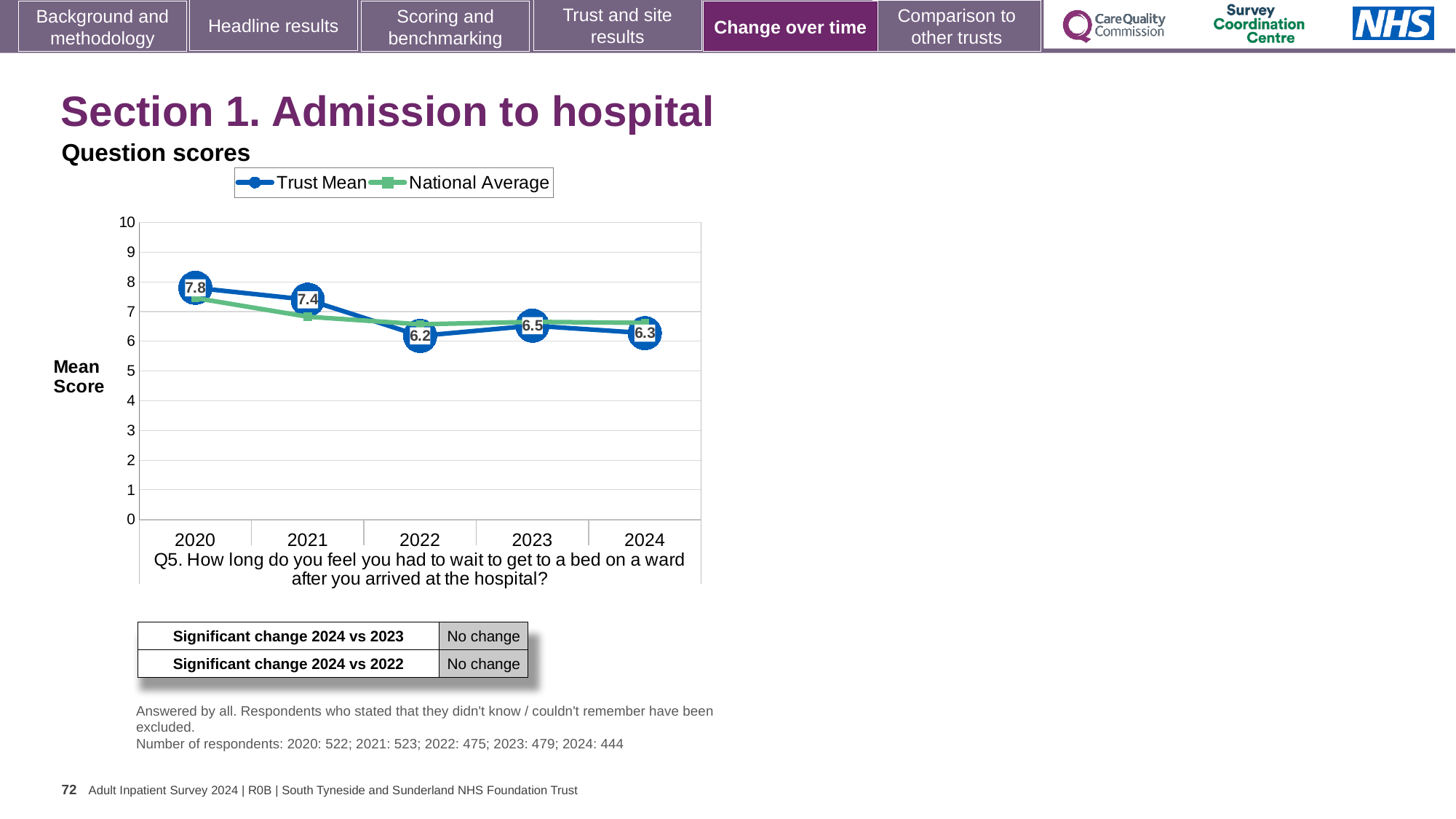
In which year is the Trust Mean score lowest? 2022 In which year is the Trust Mean score highest? 2020 Which is larger, the Trust Mean score in 2021 or in 2023? 2021 What is the Trust Mean score for 2024? 6.3 How many years are plotted on the x axis? 5 What is the difference between the Trust Mean score in 2020 and in 2024? 1.5 What is the Trust Mean score for 2020? 7.8 What is the Trust Mean score for 2022? 6.2 Is the National Average value for 2021 greater or less than 6? greater What kind of chart is shown on the slide? Line chart How many series does the legend list? 2 Does the Trust Mean score rise or fall from 2020 to 2022? Fall